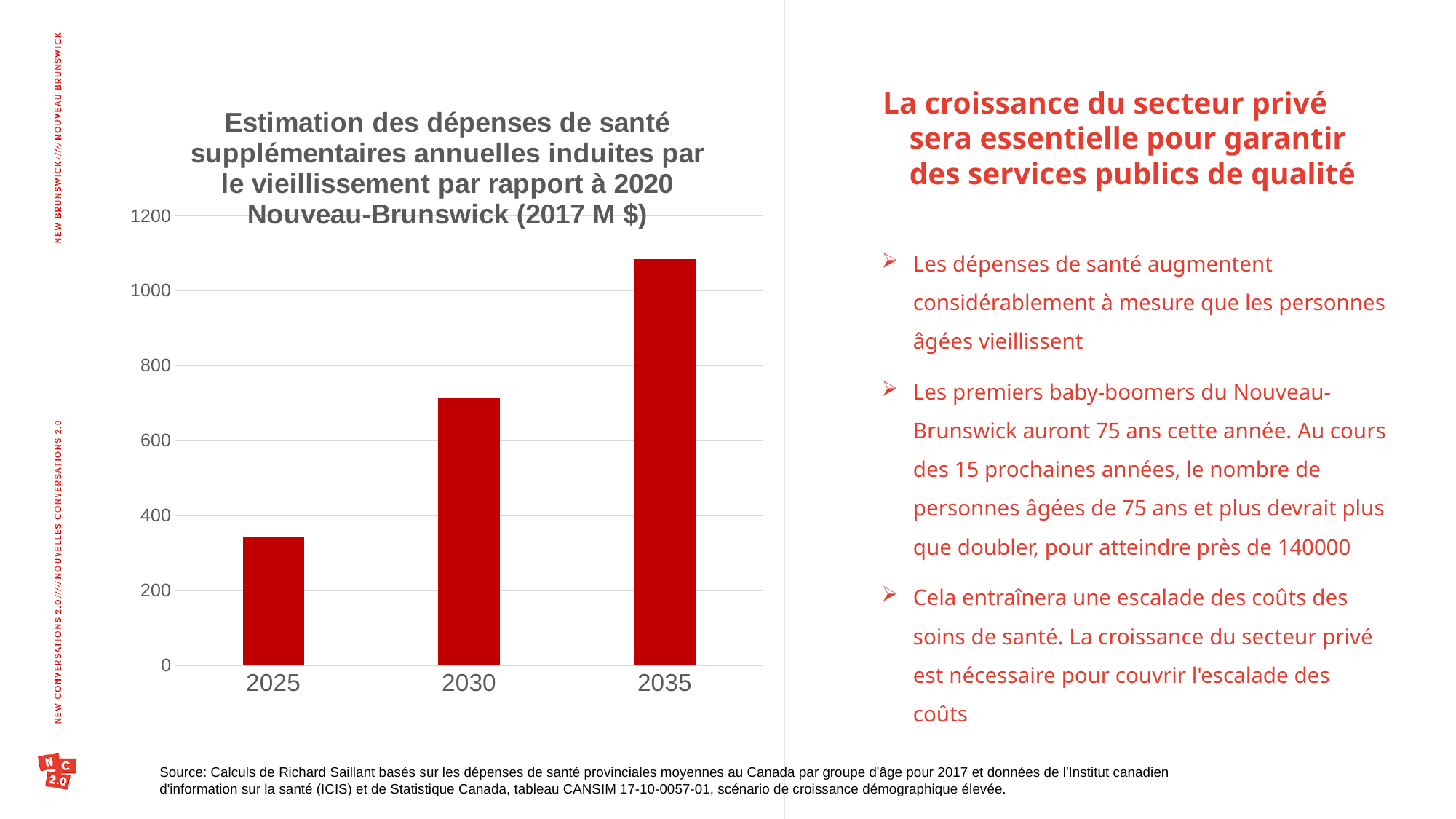
Which year has the lowest estimated additional health spending? 2025 In what unit are the values in the chart expressed, according to the title? 2017 M $ How many years are shown on the x axis of the chart? 3 Is the value for 2030 greater or less than 800? less Do the values rise or fall from 2025 to 2035? rise Which is larger, the value for 2030 or the value for 2025? 2030 What is the highest value shown on the chart's vertical axis? 1200 Which year has the highest estimated additional health spending? 2035 Is the value for 2035 greater or less than 1000? greater Is the value for 2025 greater or less than 400? less What kind of chart is shown on the slide? bar chart